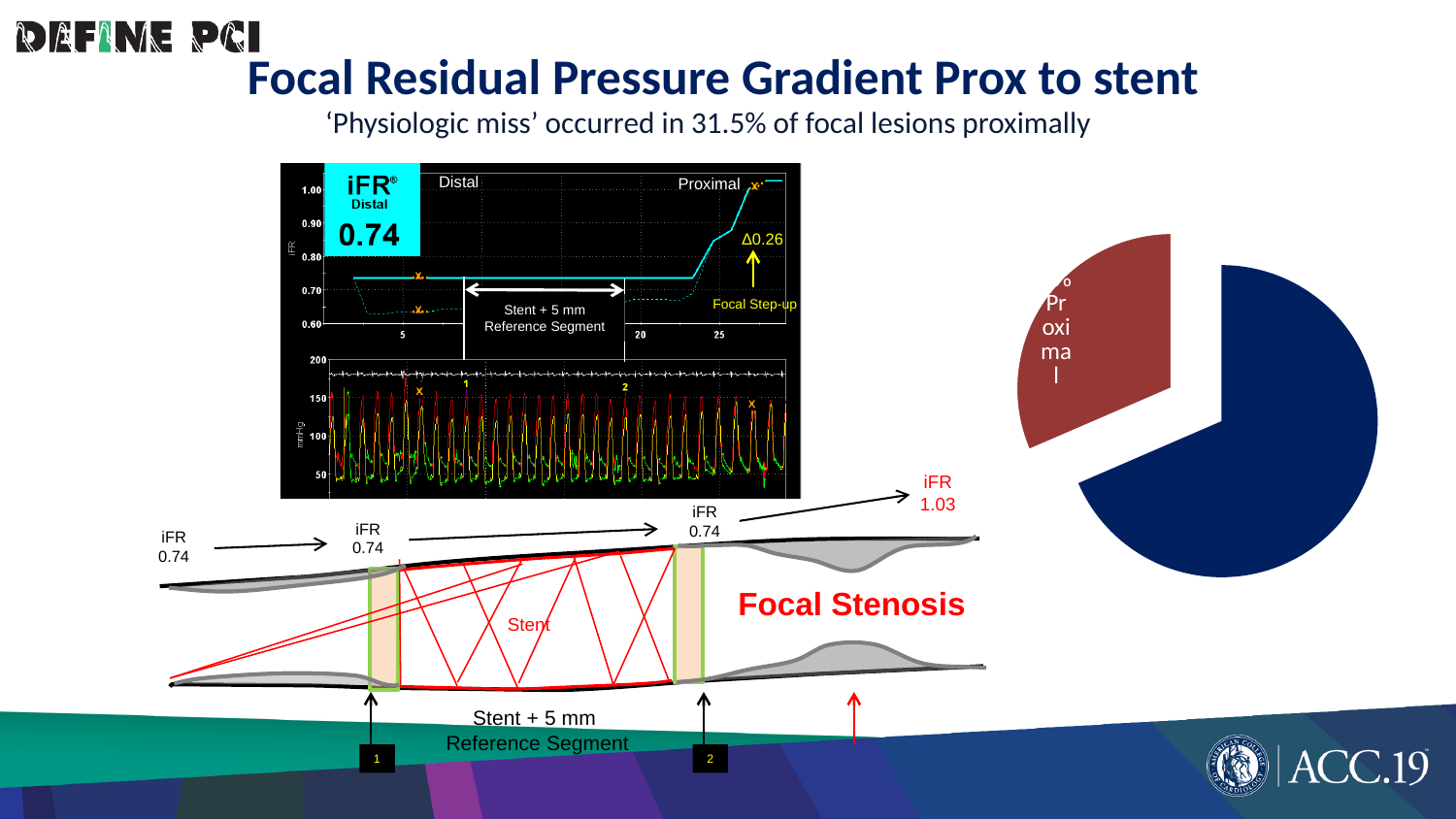
What kind of chart is shown on the right side of the slide? pie chart In the upper-left iFR pullback chart, is the distal iFR value greater or less than 0.80? less In the upper-left iFR pullback chart, what is the iFR Distal value shown in the cyan box? 0.74 What is the y-axis label of the lower pressure trace panel in the upper-left chart? mmHg In the upper-left iFR pullback chart, what is the focal step-up delta value printed next to the yellow arrow? Δ0.26 What kind of chart is the iFR pullback trace in the upper-left panel? line chart In the pie chart on the right, which slice is larger: the Proximal slice or the dark blue slice? the dark blue slice How many slices does the pie chart on the right have? 2 What colour is the Proximal slice in the pie chart on the right? dark red In the upper-left iFR pullback chart, does the iFR line rise or fall when moving from the distal end to the proximal end? rise What is the highest y-axis tick shown on the upper iFR pullback trace? 1.00 In the pie chart on the right, is the Proximal slice more or less than half of the pie? less